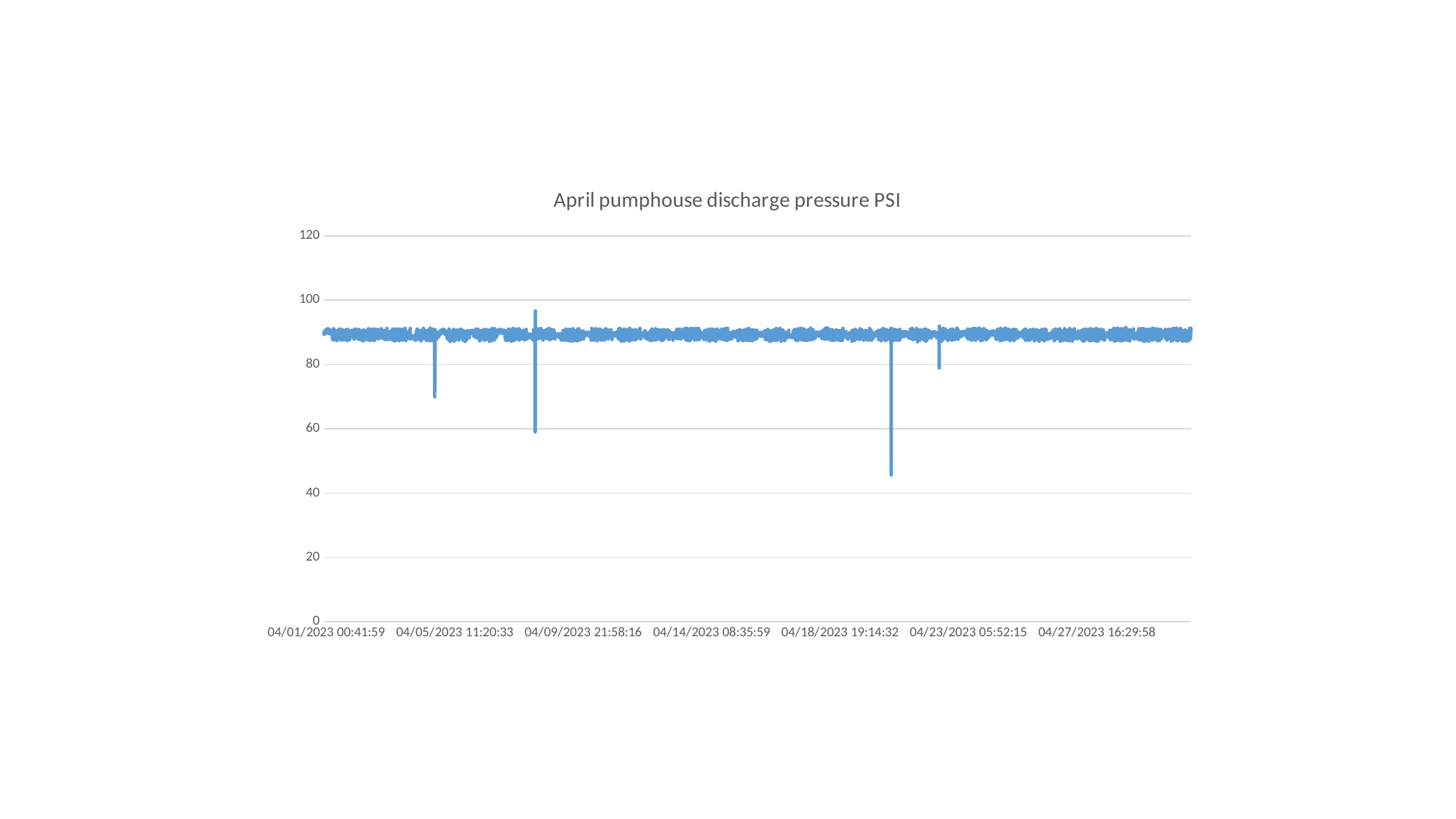
How many times does the pressure drop below 50 during the month? 1 What is the first date label on the x axis? 04/01/2023 00:41:59 Is the typical discharge pressure across April greater or less than 80? greater What type of chart is shown on the slide? line chart Is the lowest pressure value recorded in the chart greater or less than 40? greater How many date labels are shown along the x axis? 7 Is the highest pressure value recorded in the chart greater or less than 100? less What is the highest value shown on the vertical axis? 120 Near which x-axis label does the deepest drop in pressure occur? 04/18/2023 19:14:32 What is the title of the chart? April pumphouse discharge pressure PSI Does the discharge pressure generally rise, fall, or stay flat across April? stays flat